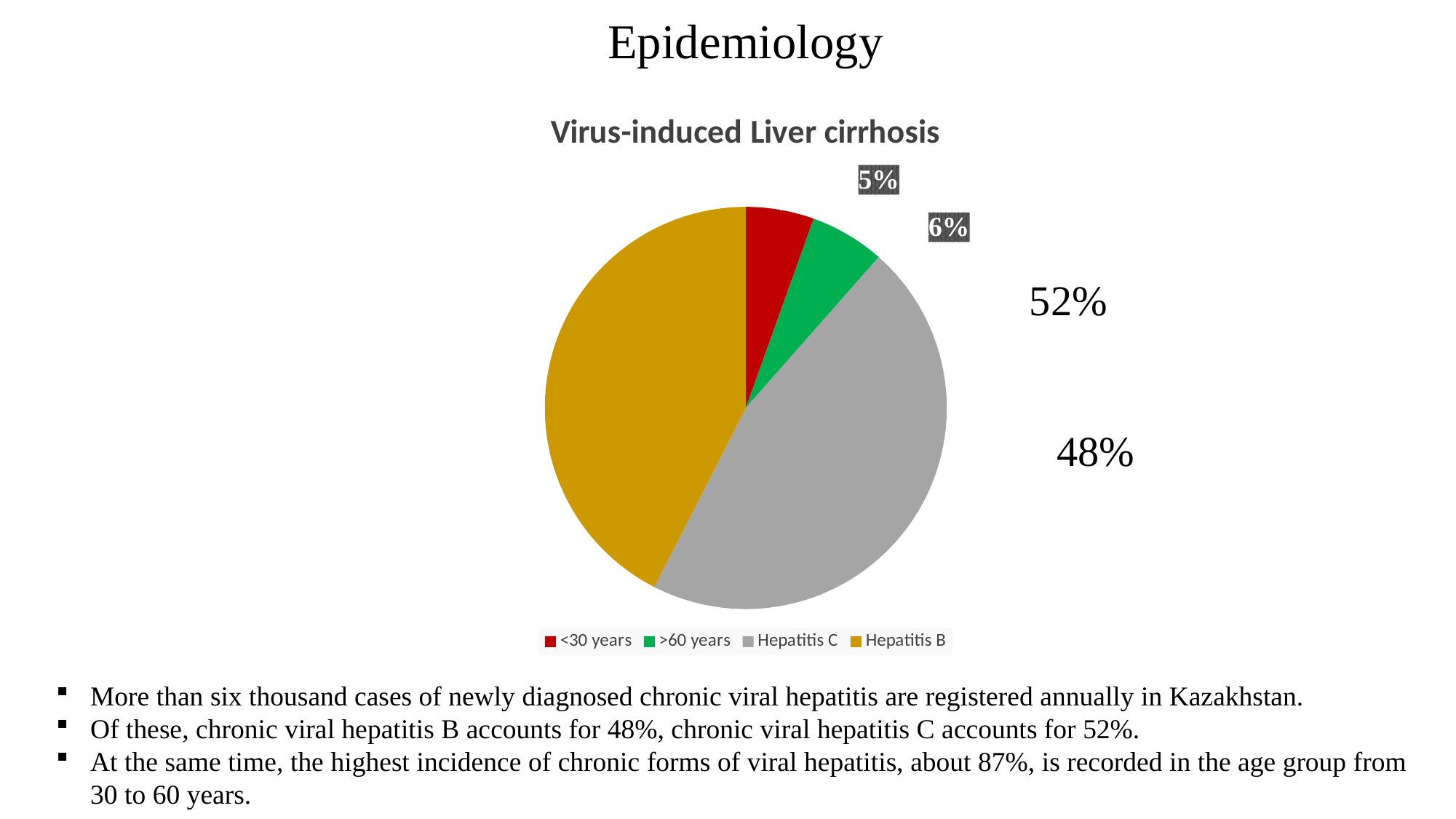
What type of chart is shown on the slide? Pie chart What is the title of the chart? Virus-induced Liver cirrhosis Which category has the smallest slice of the pie? <30 years How many entries does the chart legend list? 4 How many slices does the pie chart have? 4 What percentage is shown for the >60 years slice? 6% Which slice is larger, <30 years or >60 years? >60 years What colour is the Hepatitis B slice in the pie chart? Gold What percentage is shown for the <30 years slice? 5% What is the difference between the >60 years and <30 years percentages? 1%